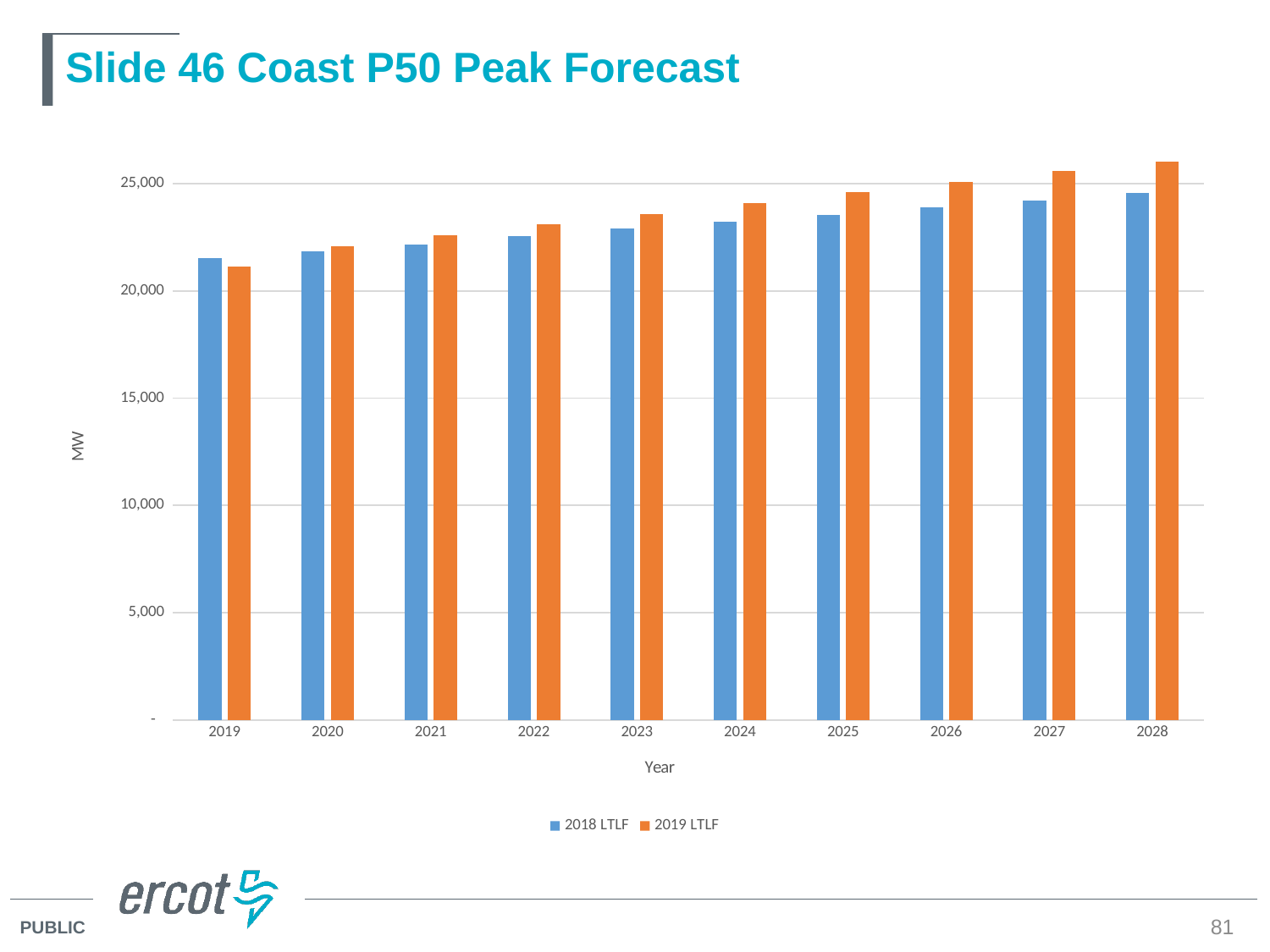
Is the 2019 LTLF value for 2028 greater or less than 25,000? greater How many series does the legend list? 2 Is the 2018 LTLF value for 2019 greater or less than 20,000? greater Is the 2019 LTLF value for 2024 greater or less than 25,000? less What is the label on the vertical axis? MW How many years are shown on the x axis? 10 Do the 2019 LTLF values rise or fall from 2019 to 2028? Rise What kind of chart is shown on the slide? Bar chart In which year is the 2018 LTLF value lowest? 2019 For 2028, which series has the larger value, 2018 LTLF or 2019 LTLF? 2019 LTLF In which year is the 2019 LTLF value highest? 2028